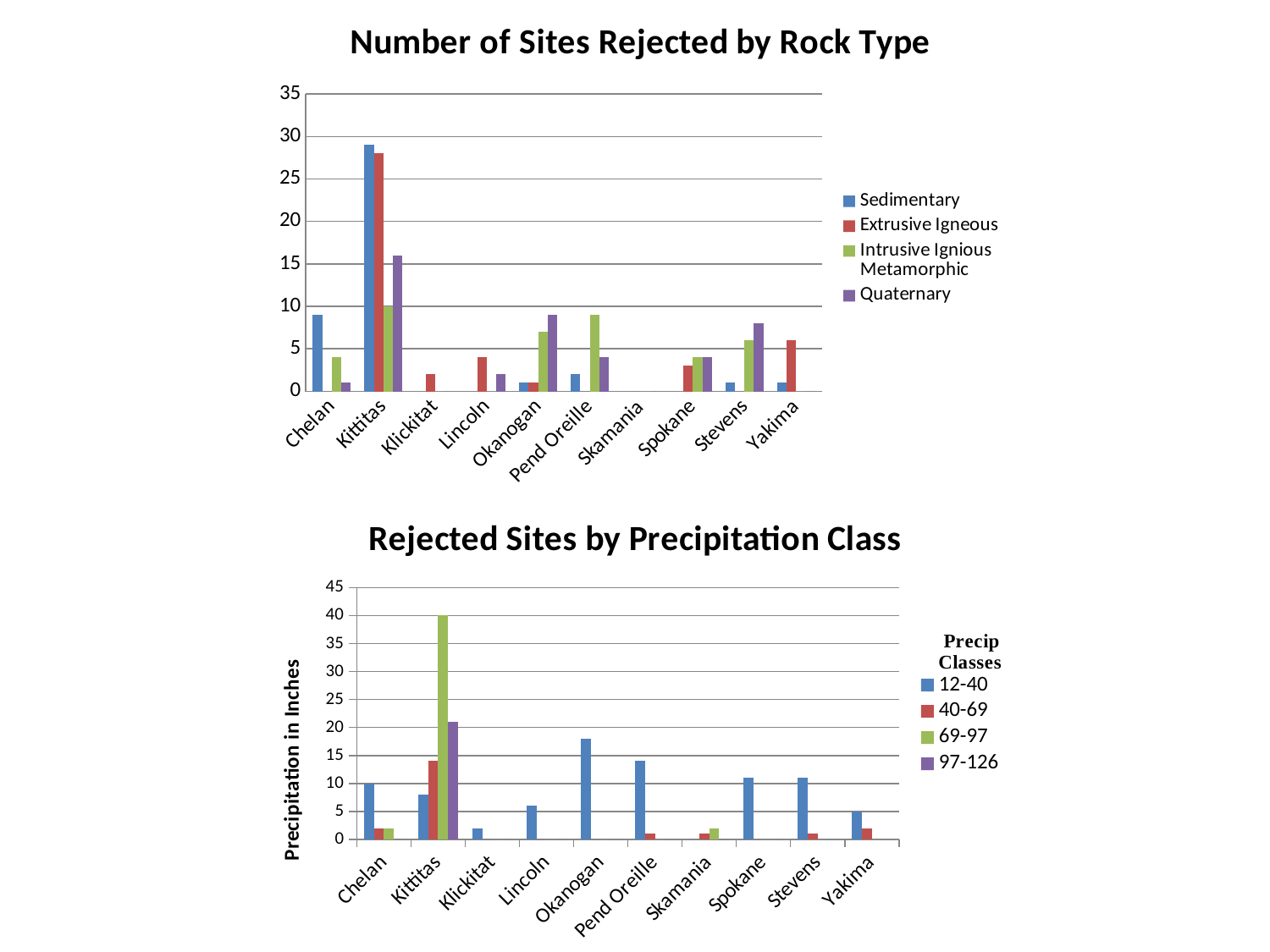
In the chart titled "Number of Sites Rejected by Rock Type", is the Quaternary value for Kittitas greater or less than 15? greater In the chart titled "Rejected Sites by Precipitation Class", how many precipitation classes does the legend list? 4 In the chart titled "Number of Sites Rejected by Rock Type", which county has the highest Sedimentary value? Kittitas In the chart titled "Number of Sites Rejected by Rock Type", is the Sedimentary value for Kittitas greater or less than 25? greater In the chart titled "Rejected Sites by Precipitation Class", what is the label of the y axis? Precipitation in Inches In the chart titled "Rejected Sites by Precipitation Class", is the 69-97 value for Kittitas greater or less than 35? greater In the chart titled "Rejected Sites by Precipitation Class", which county has the highest 69-97 value? Kittitas In the chart titled "Number of Sites Rejected by Rock Type", what kind of chart is shown? bar chart In the chart titled "Rejected Sites by Precipitation Class", which is larger: the 12-40 value for Okanogan or the 12-40 value for Lincoln? Okanogan In the chart titled "Number of Sites Rejected by Rock Type", how many counties are shown on the x axis? 10 In the chart titled "Number of Sites Rejected by Rock Type", how many series does the legend list? 4 In the chart titled "Number of Sites Rejected by Rock Type", which is larger for Okanogan: the Quaternary value or the Sedimentary value? Quaternary